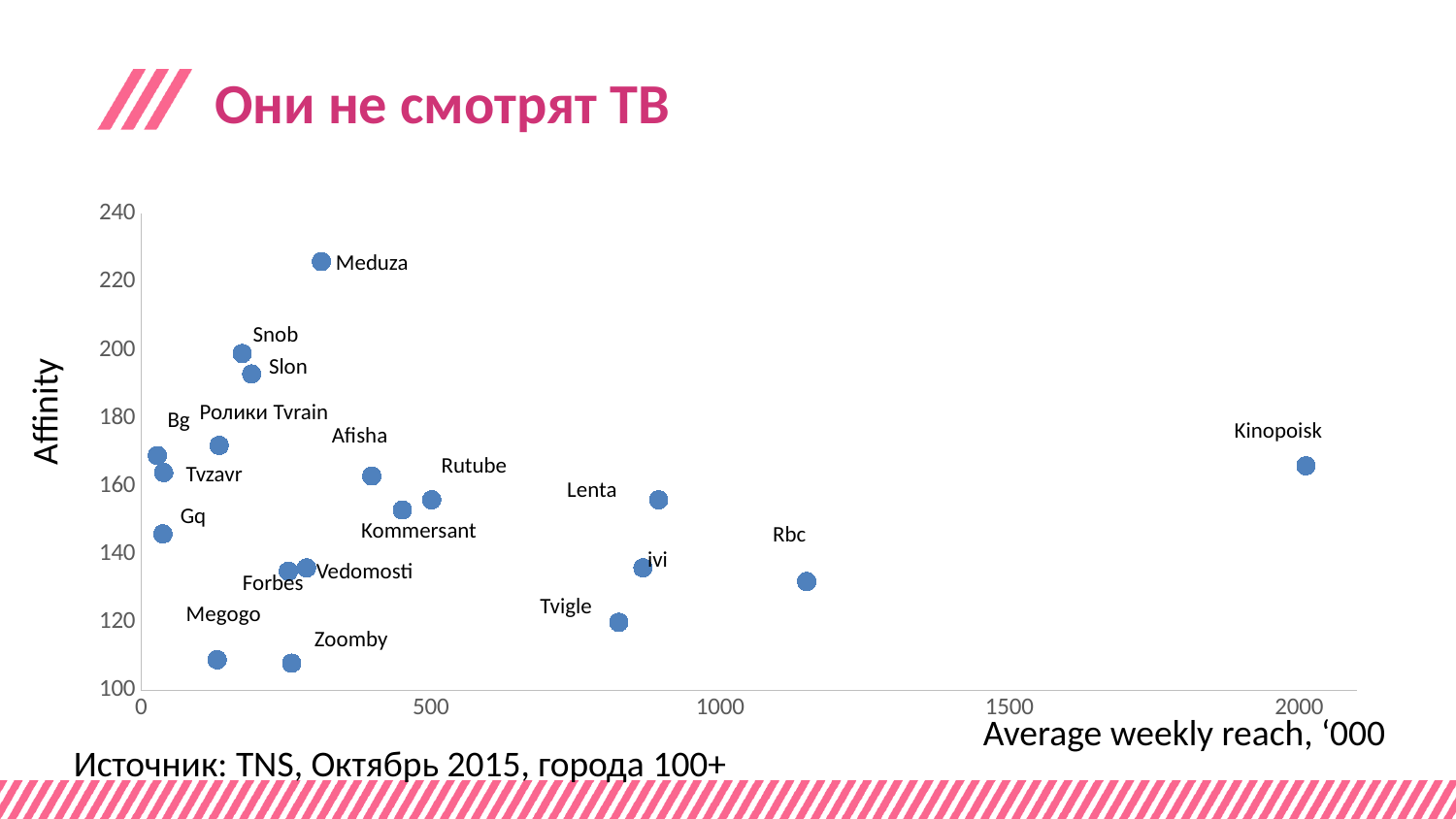
Which has the higher Affinity value, Snob or Slon? Snob Is the Affinity value for Rbc greater or less than 140? less Is the Affinity value for Tvigle greater or less than 140? less What kind of chart is shown on the slide? scatter chart Is the Average weekly reach for Kinopoisk greater or less than 1500? greater How many labelled points are plotted on the chart? 19 Which point has the highest Average weekly reach? Kinopoisk What is the label of the horizontal axis? Average weekly reach, '000 Which point has the highest Affinity value? Meduza Which has the higher Affinity value, Lenta or ivi? Lenta